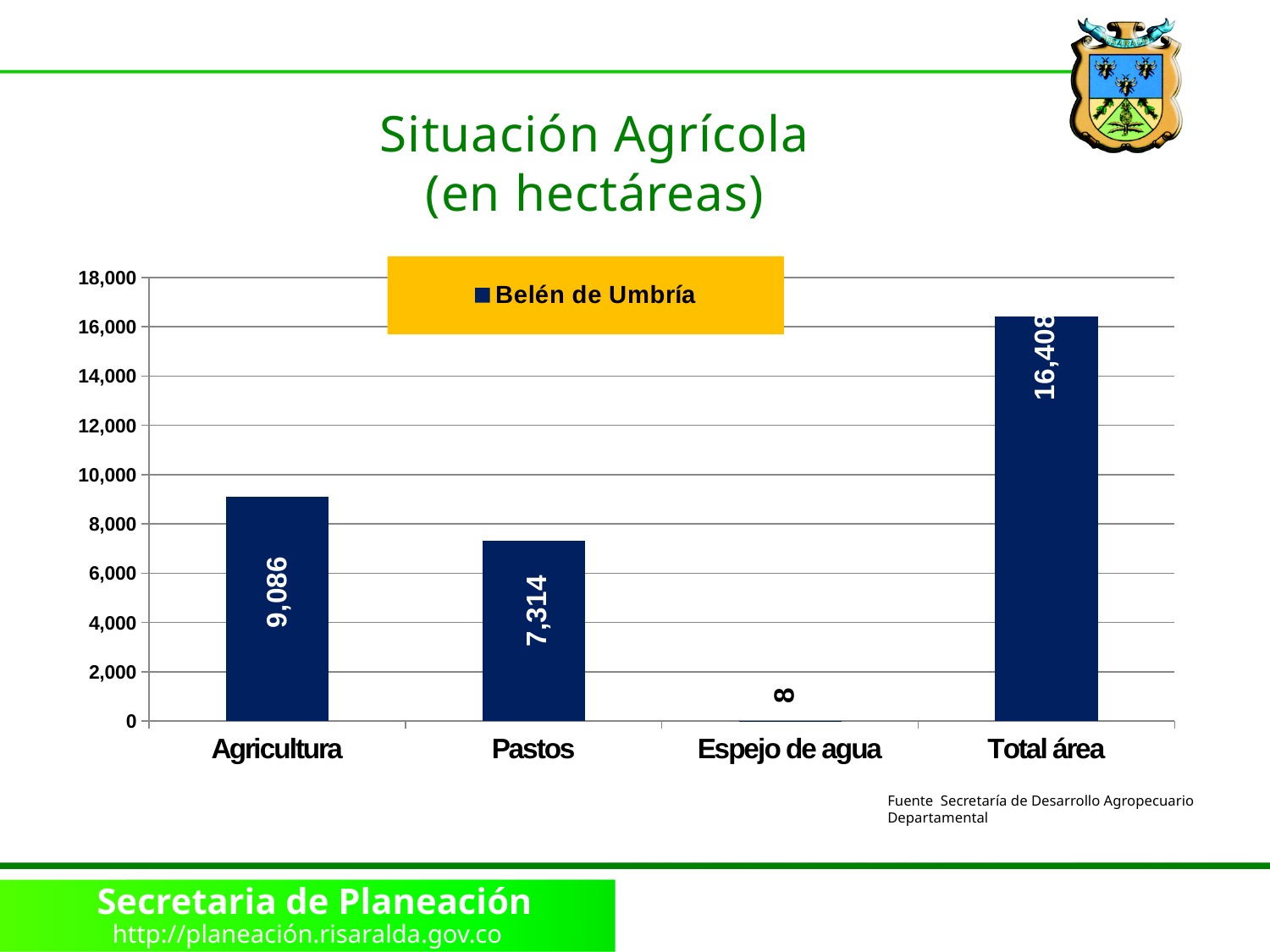
Which category has the lowest value? Espejo de agua What is the value for Agricultura? 9,086 What is the value for Total área? 16,408 Which is larger, the value for Agricultura or the value for Pastos? Agricultura What kind of chart is shown on the slide? bar chart Which category has the highest value? Total área What is the value for Pastos? 7,314 Is the value for Pastos greater or less than 8,000? less What is the difference between the values for Agricultura and Pastos? 1,772 How many categories are shown on the x axis? 4 What is the value for Espejo de agua? 8 What series name does the legend show? Belén de Umbría